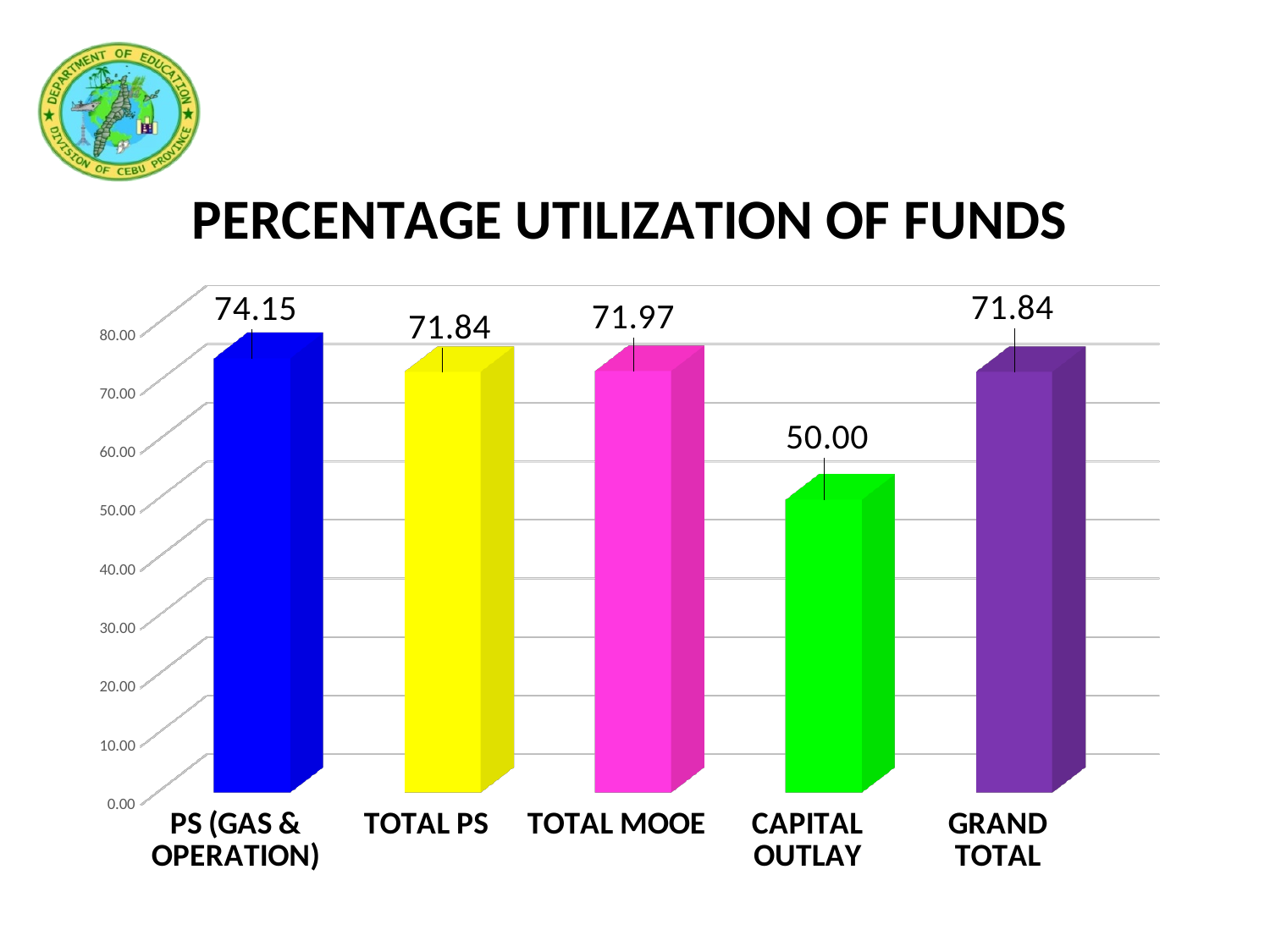
What is the value for CAPITAL OUTLAY? 50.00 What is the value for GRAND TOTAL? 71.84 What is the value for TOTAL MOOE? 71.97 Which category has the highest value? PS (GAS & OPERATION) What is the difference between the values for PS (GAS & OPERATION) and CAPITAL OUTLAY? 24.15 Which category has the lowest value? CAPITAL OUTLAY What is the difference between the values for TOTAL MOOE and TOTAL PS? 0.13 Which is larger, the value for TOTAL PS or the value for CAPITAL OUTLAY? TOTAL PS How many categories are shown in the chart? 5 What is the title of the chart? PERCENTAGE UTILIZATION OF FUNDS What kind of chart is shown on the slide? Bar chart What is the value for PS (GAS & OPERATION)? 74.15